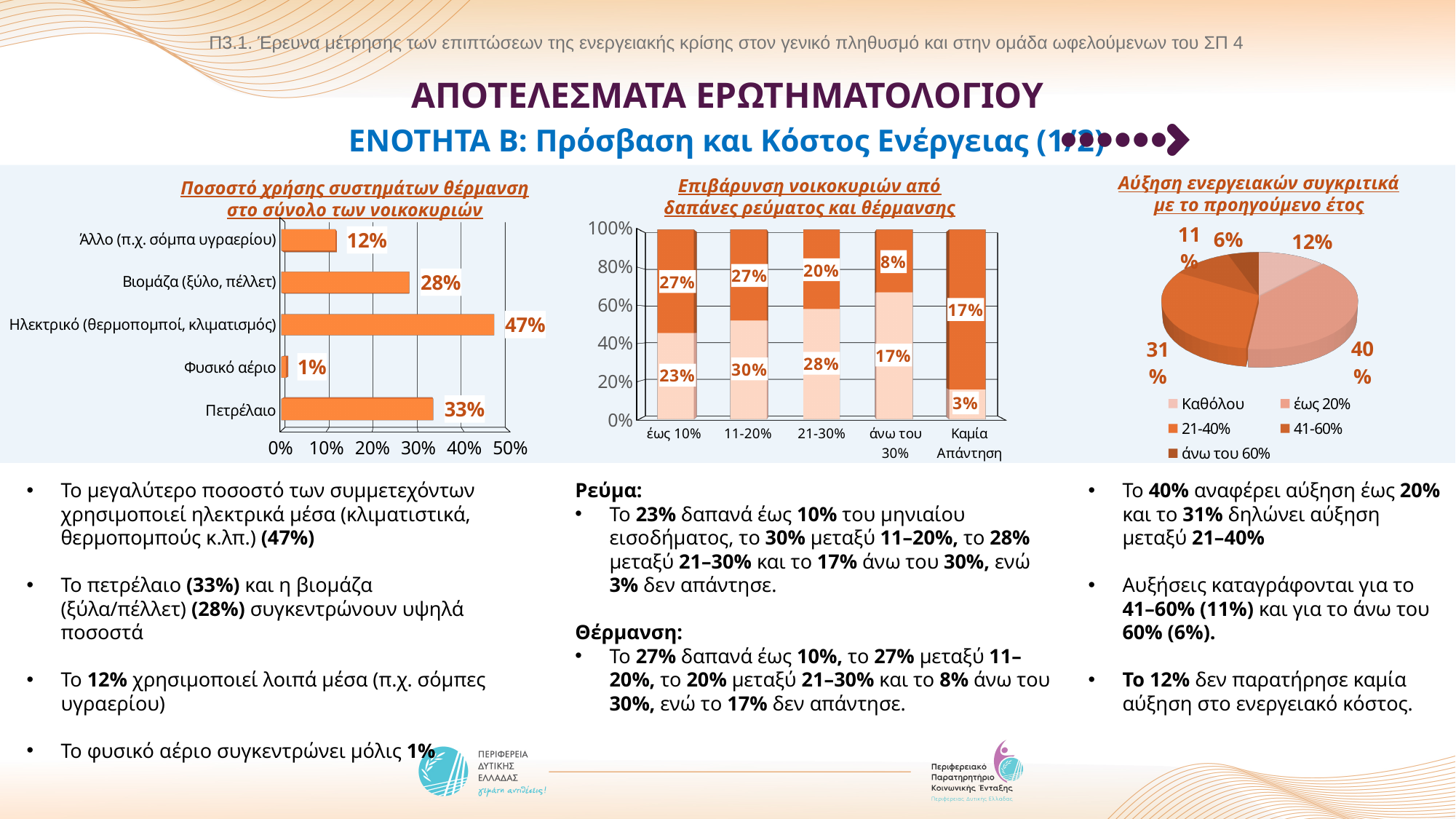
In the pie chart 'Αύξηση ενεργειακών συγκριτικά με το προηγούμενο έτος', what share does the slice 'έως 20%' have? 40% In the chart 'Ποσοστό χρήσης συστημάτων θέρμανση στο σύνολο των νοικοκυριών', what is the value for Ηλεκτρικό (θερμοπομποί, κλιματισμός)? 47% In the chart 'Ποσοστό χρήσης συστημάτων θέρμανση στο σύνολο των νοικοκυριών', what is the difference between Πετρέλαιο and Βιομάζα (ξύλο, πέλλετ)? 5% In the chart 'Ποσοστό χρήσης συστημάτων θέρμανση στο σύνολο των νοικοκυριών', how many categories are shown? 5 In the pie chart 'Αύξηση ενεργειακών συγκριτικά με το προηγούμενο έτος', which slice is the smallest? άνω του 60% In the chart 'Ποσοστό χρήσης συστημάτων θέρμανση στο σύνολο των νοικοκυριών', which category has the lowest value? Φυσικό αέριο In the chart 'Επιβάρυνση νοικοκυριών από δαπάνες ρεύματος και θέρμανσης', what is the value of the upper (dark) segment for the category Καμία Απάντηση? 17% In the chart 'Επιβάρυνση νοικοκυριών από δαπάνες ρεύματος και θέρμανσης', which is larger for the category άνω του 30%: the lower (light) segment or the upper (dark) segment? The lower (light) segment In the chart 'Επιβάρυνση νοικοκυριών από δαπάνες ρεύματος και θέρμανσης', how many categories are on the x axis? 5 How many entries does the legend of the pie chart 'Αύξηση ενεργειακών συγκριτικά με το προηγούμενο έτος' list? 5 What kind of chart is 'Ποσοστό χρήσης συστημάτων θέρμανση στο σύνολο των νοικοκυριών'? Bar chart In the chart 'Επιβάρυνση νοικοκυριών από δαπάνες ρεύματος και θέρμανσης', what is the value of the lower (light) segment for the category 11-20%? 30%